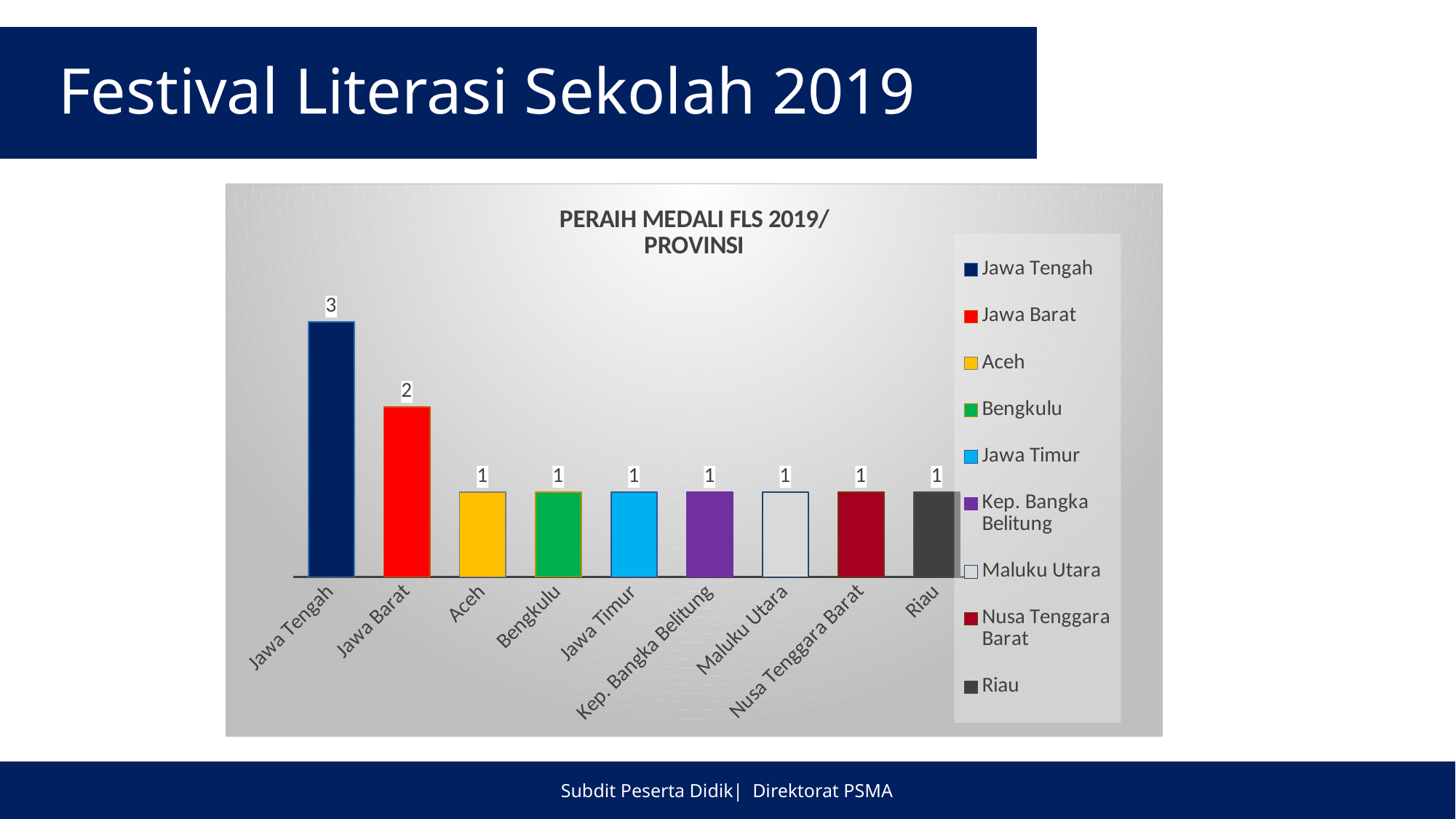
What is the value for Maluku Utara? 1 What is the difference between the values for Jawa Barat and Riau? 1 Which is larger, the value for Jawa Barat or the value for Bengkulu? Jawa Barat How many entries does the legend list? 9 What is the value for Jawa Tengah? 3 What is the value for Aceh? 1 What is the difference between the values for Jawa Tengah and Jawa Barat? 1 How many provinces are shown on the chart? 9 Which province has the highest value? Jawa Tengah What is the value for Jawa Barat? 2 What kind of chart is shown? Bar chart What is the title of the chart? PERAIH MEDALI FLS 2019/ PROVINSI